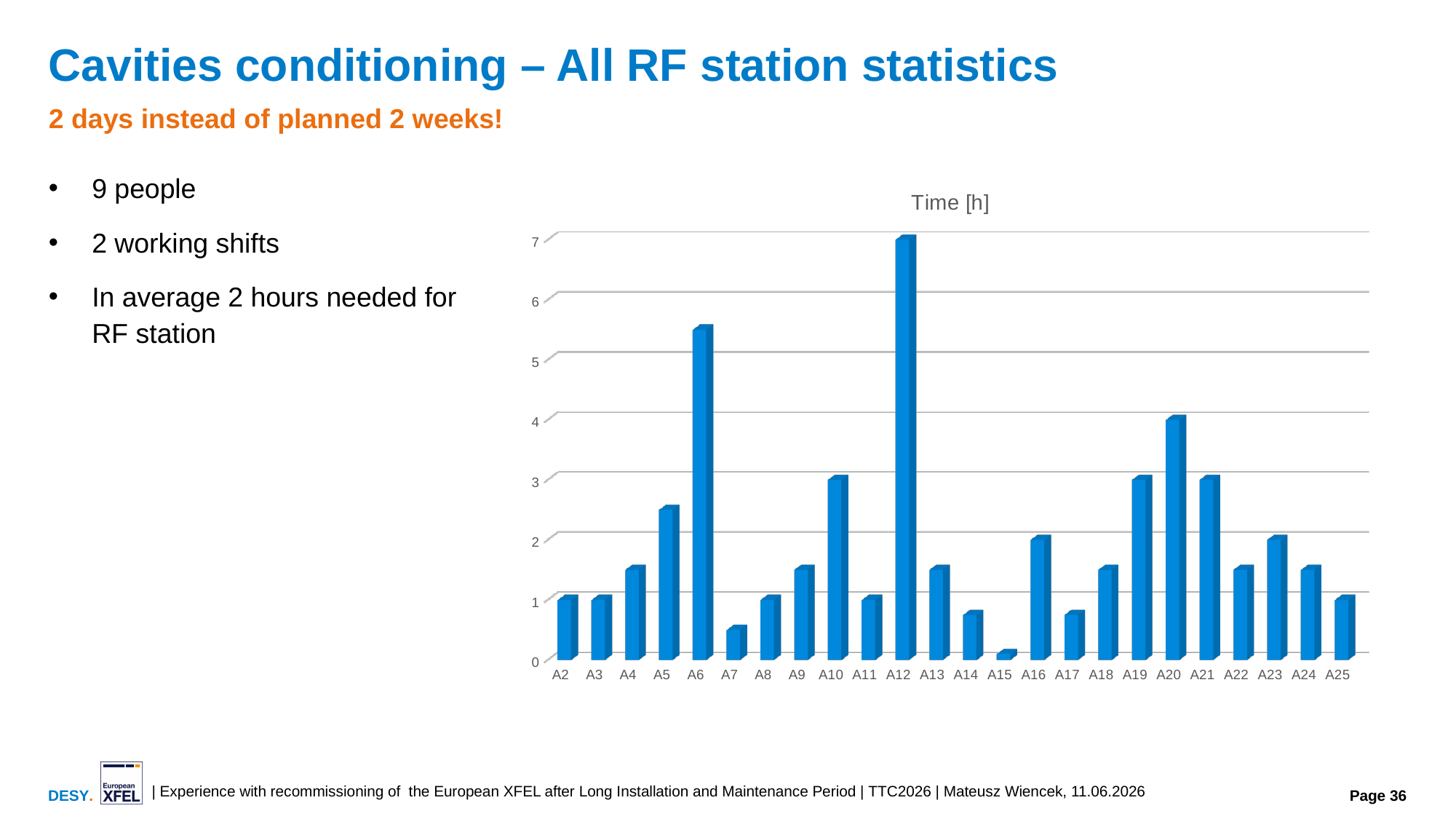
What is the value for A12 in the chart? 7 What kind of chart is shown on the slide? bar chart What is the difference between the values for A12 and A20? 3 Which has the larger value, A6 or A20? A6 What is the value for A20 in the chart? 4 Is the value for A6 greater or less than 5? greater How many RF stations (categories) are shown on the x axis of the chart? 24 What is the title of the chart? Time [h] Which RF station has the highest value in the chart? A12 Which RF station has the lowest value in the chart? A15 What is the value for A16 in the chart? 2 Is the value for A7 greater or less than 1? less